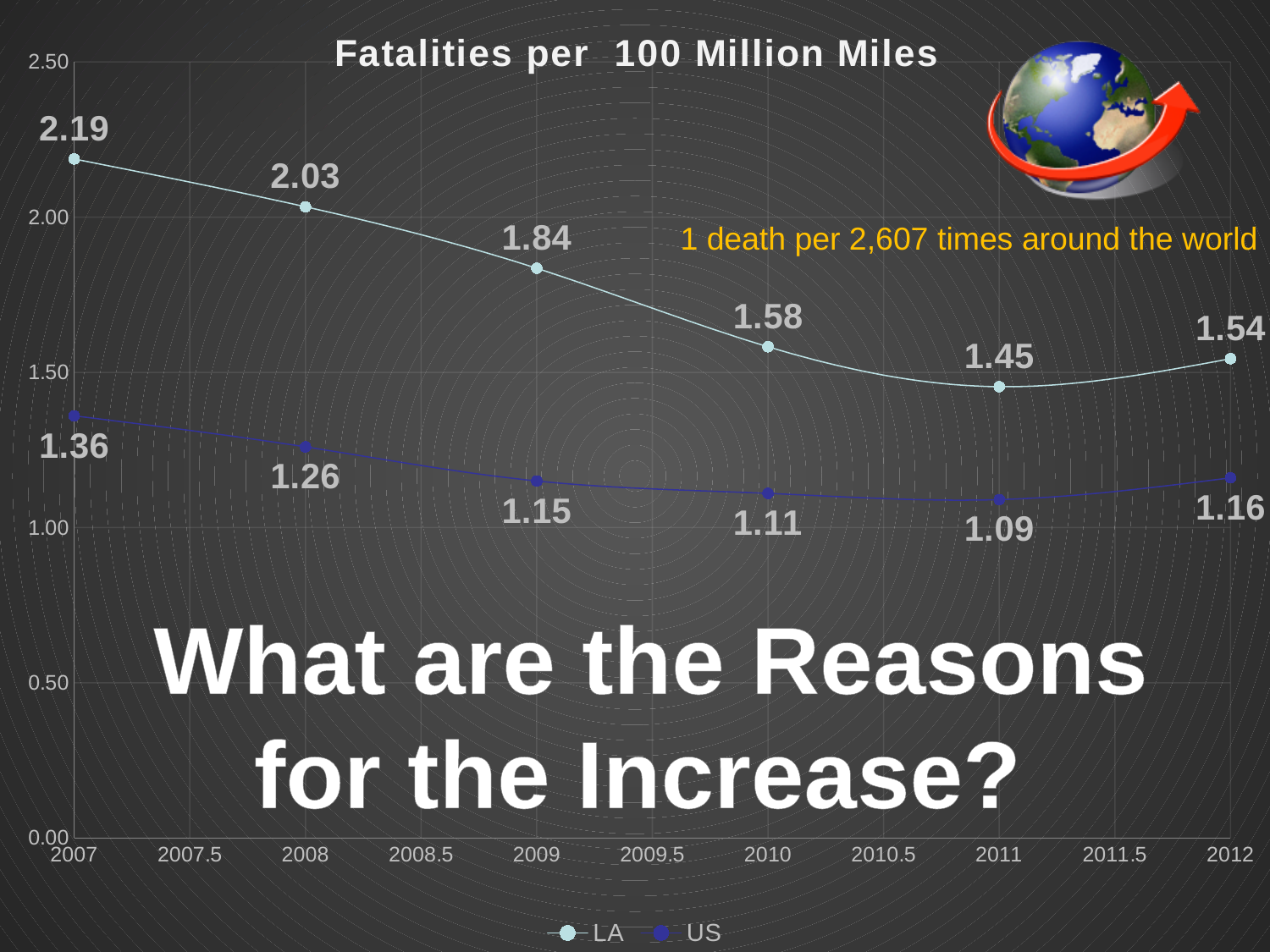
What is the title of the chart? Fatalities per 100 Million Miles Is the LA value for 2009 greater or less than 2.00? less Which is larger, the LA value in 2008 or the LA value in 2009? LA value in 2008 What is the LA value for 2007? 2.19 What is the US value for 2011? 1.09 What kind of chart is shown? line chart How many series does the legend list? 2 What is the difference between the LA and US values in 2010? 0.47 In which year is the US series highest? 2007 In which year is the LA series lowest? 2011 What is the LA value for 2012? 1.54 What is the US value for 2009? 1.15